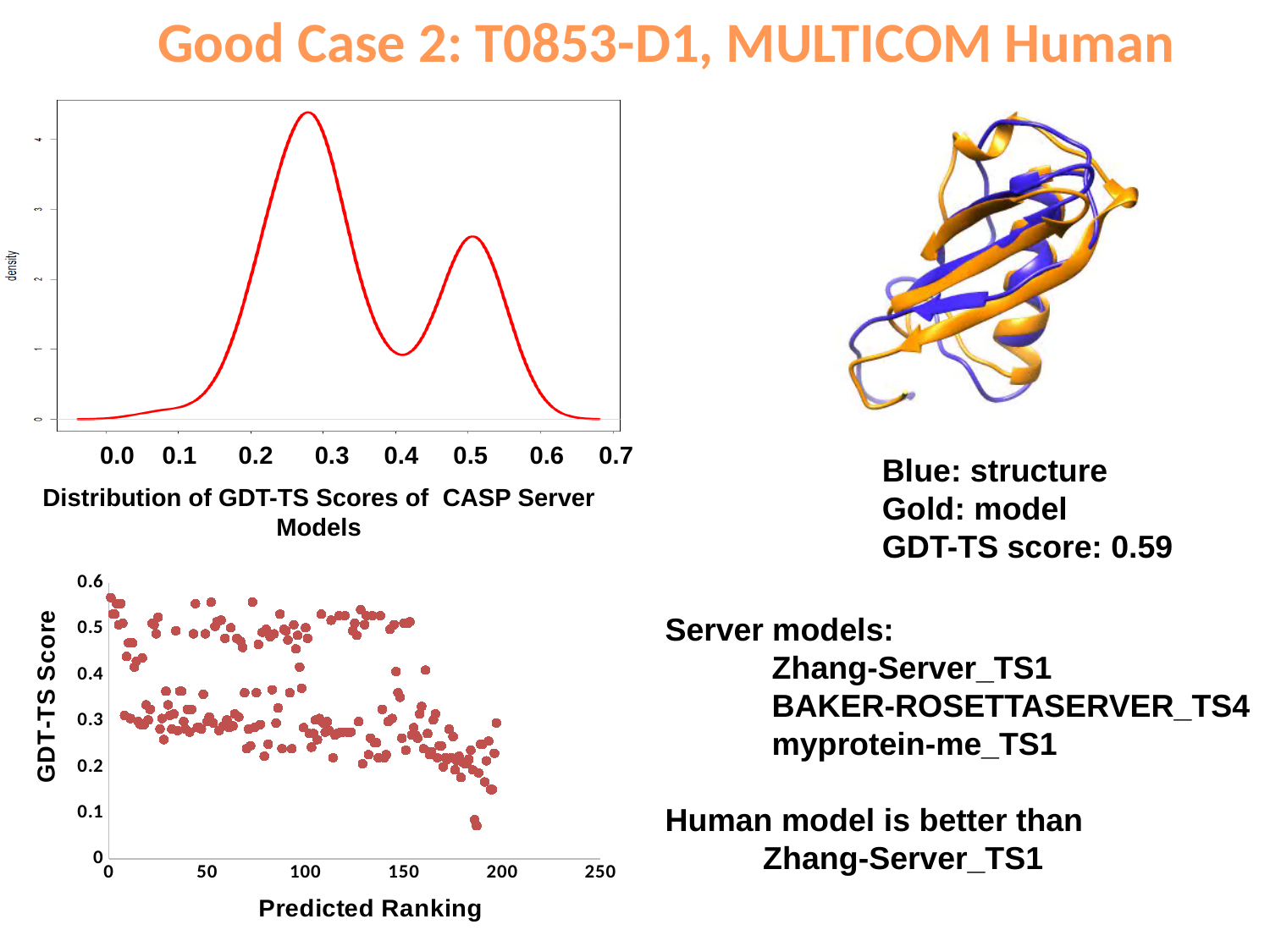
In the bottom-left scatter plot, is the highest GDT-TS score plotted greater or less than 0.6? less What kind of chart is the top-left chart titled 'Distribution of GDT-TS Scores of CASP Server Models'? Line chart (density curve) What kind of chart is the bottom-left chart with 'Predicted Ranking' on the x axis? Scatter plot What is the label of the x axis of the bottom-left scatter plot? Predicted Ranking In the top-left density chart, is the height of the tallest peak greater or less than 4? greater In the bottom-left scatter plot, is the largest predicted ranking plotted greater or less than 250? less In the top-left density chart, which peak is higher: the one near a GDT-TS score of 0.3 or the one near 0.5? The one near 0.3 In the bottom-left scatter plot, do GDT-TS scores generally rise or fall as the predicted ranking increases? fall What is the label of the y axis of the bottom-left scatter plot? GDT-TS Score